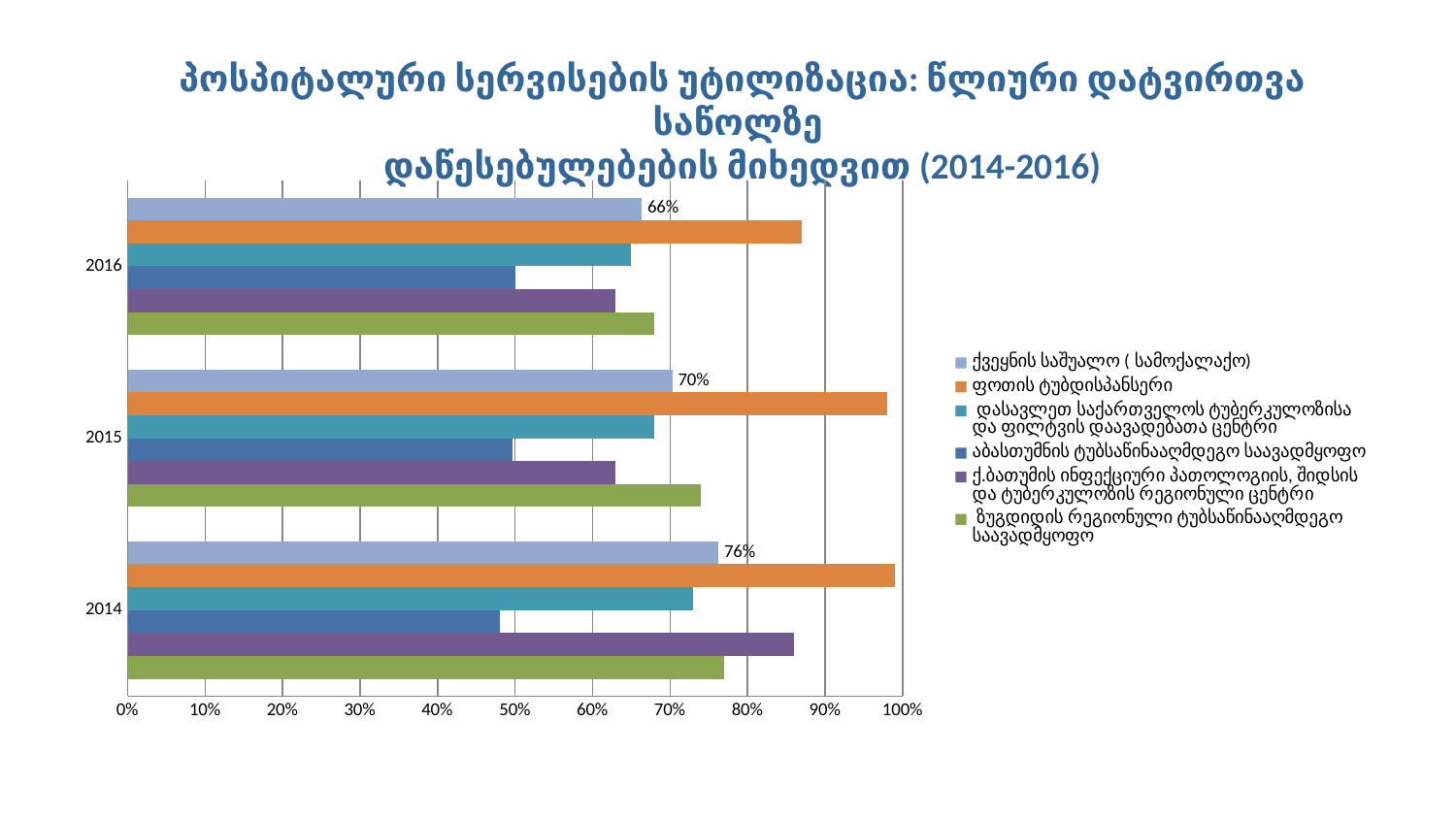
Which is larger for ქვეყნის საშუალო ( სამოქალაქო): the 2014 value or the 2016 value? 2014 What is the value for ქვეყნის საშუალო ( სამოქალაქო) in 2016? 66% Which series has the lowest value in 2014? აბასთუმნის ტუბსანინააღმდეგო საავადმყოფო Is the value for აბასთუმნის ტუბსანინააღმდეგო საავადმყოფო in 2014 greater or less than 50%? less What is the value for ქვეყნის საშუალო ( სამოქალაქო) in 2014? 76% What is the value for ქვეყნის საშუალო ( სამოქალაქო) in 2015? 70% Is the value for ფოთის ტუბდისპანსერი in 2014 greater or less than 90%? greater By how many percentage points does the ქვეყნის საშუალო ( სამოქალაქო) value in 2014 exceed the value in 2016? 10 percentage points Is the value for ქ.ბათუმის ინფექციური პათოლოგიის, შიდსის და ტუბერკულოზის რეგიონული ცენტრი in 2014 greater or less than 80%? greater Which series has the highest value in 2014? ფოთის ტუბდისპანსერი How many series does the legend list? 6 What kind of chart is shown on the slide? Bar chart